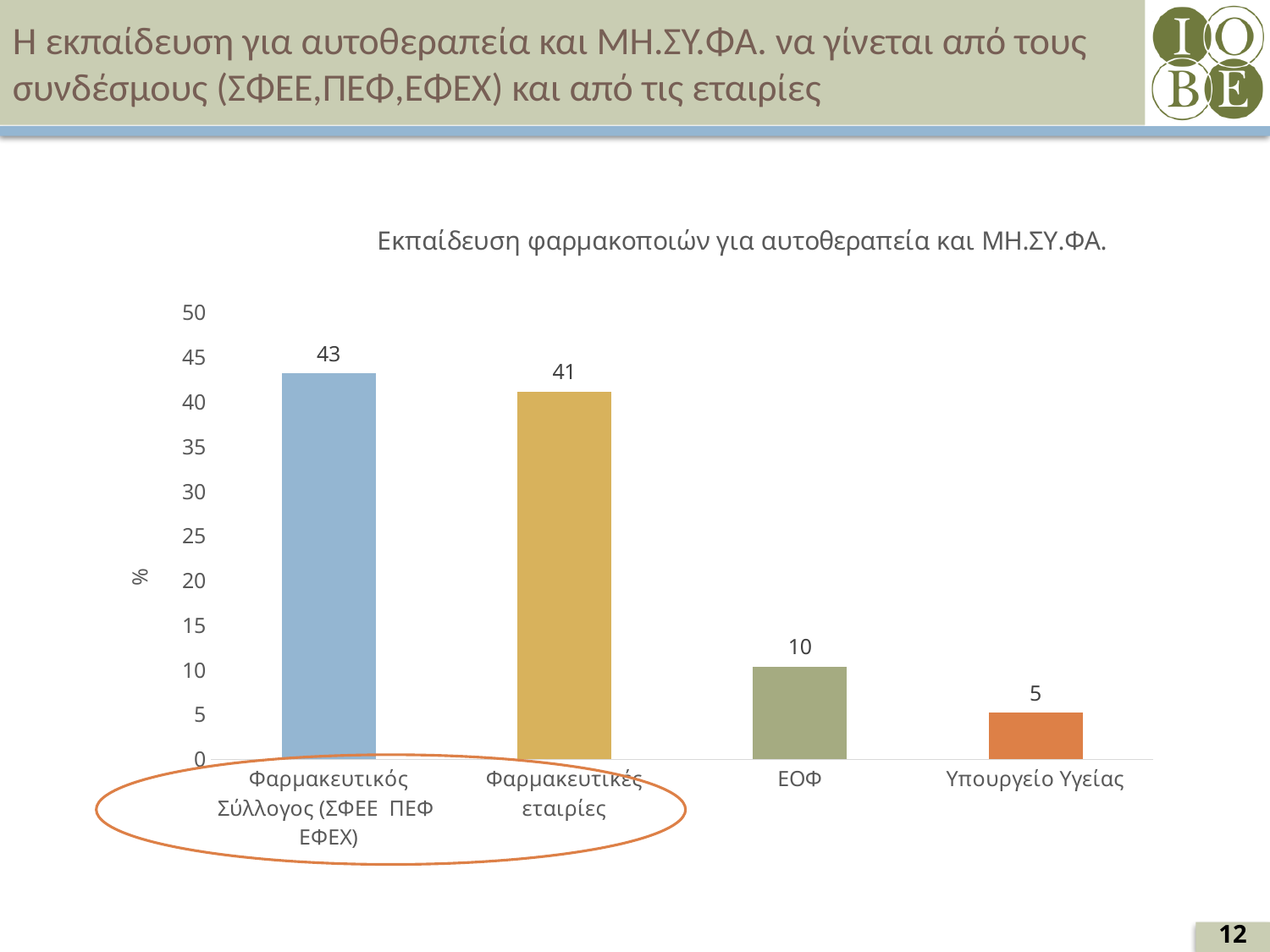
What is the value for Υπουργείο Υγείας? 5 What kind of chart is shown on the slide? bar chart How many categories are shown on the x axis? 4 What is the value for Φαρμακευτικές εταιρίες? 41 Which is larger, the value for ΕΟΦ or the value for Υπουργείο Υγείας? ΕΟΦ What is the difference between the values for Φαρμακευτικός Σύλλογος (ΣΦΕΕ ΠΕΦ ΕΦΕΧ) and Φαρμακευτικές εταιρίες? 2 What is the value for ΕΟΦ? 10 Which category has the highest value? Φαρμακευτικός Σύλλογος (ΣΦΕΕ ΠΕΦ ΕΦΕΧ) Is the value for Φαρμακευτικές εταιρίες greater or less than 30? greater What is the title of the chart? Εκπαίδευση φαρμακοποιών για αυτοθεραπεία και ΜΗ.ΣΥ.ΦΑ. Which category has the lowest value? Υπουργείο Υγείας What is the difference between the values for ΕΟΦ and Υπουργείο Υγείας? 5